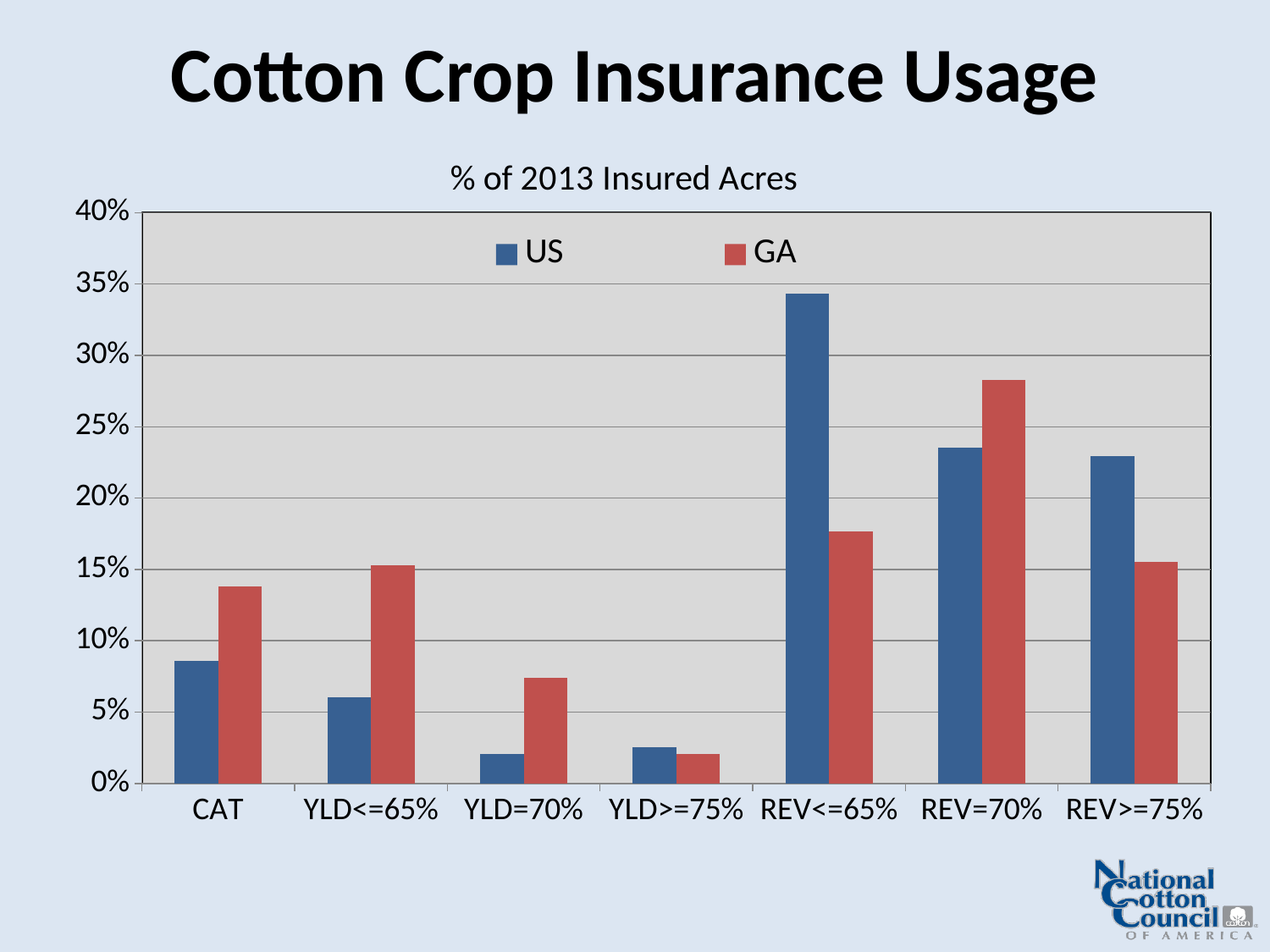
Is the US value for CAT greater or less than 10%? less How many series does the legend list? 2 For which category is the US value highest? REV<=65% For REV=70%, which series has the larger value, US or GA? GA For which category is the GA value highest? REV=70% What is the subtitle shown above the chart? % of 2013 Insured Acres Is the US value for REV<=65% greater or less than 30%? greater Is the US value for YLD=70% greater or less than 5%? less How many categories are shown on the x axis? 7 For which category is the GA value lowest? YLD>=75% What kind of chart is shown on the slide? bar chart